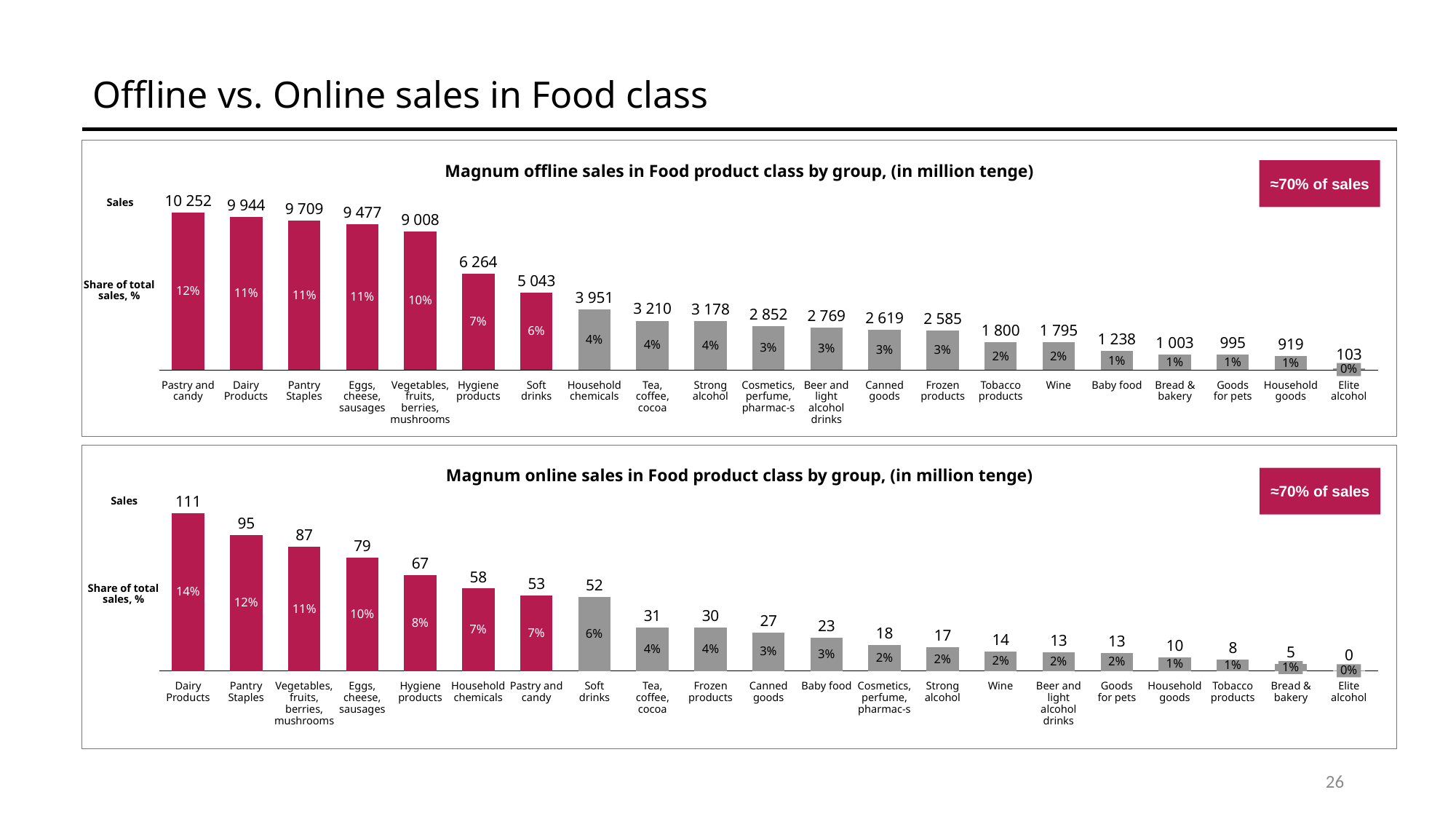
In the offline sales chart, what is the difference in sales between Pastry and candy and Dairy Products? 308 In the offline sales chart, do the sales values rise or fall from left to right? Fall What type of chart is the online sales chart? Bar chart In the online sales chart, which group has the highest sales? Dairy Products In the online sales chart, what is the difference in sales between Pantry Staples and Soft drinks? 43 What is the title of the top chart? Magnum offline sales in Food product class by group, (in million tenge) In the offline sales chart, what are the sales for Pastry and candy? 10 252 In the offline sales chart, which group has the lowest sales? Elite alcohol How many product groups are shown in the offline sales chart? 21 In the online sales chart, which has higher sales: Household chemicals or Pastry and candy? Household chemicals In the offline sales chart, what is the share of total sales for Hygiene products? 7% In the online sales chart, what are the sales for Dairy Products? 111